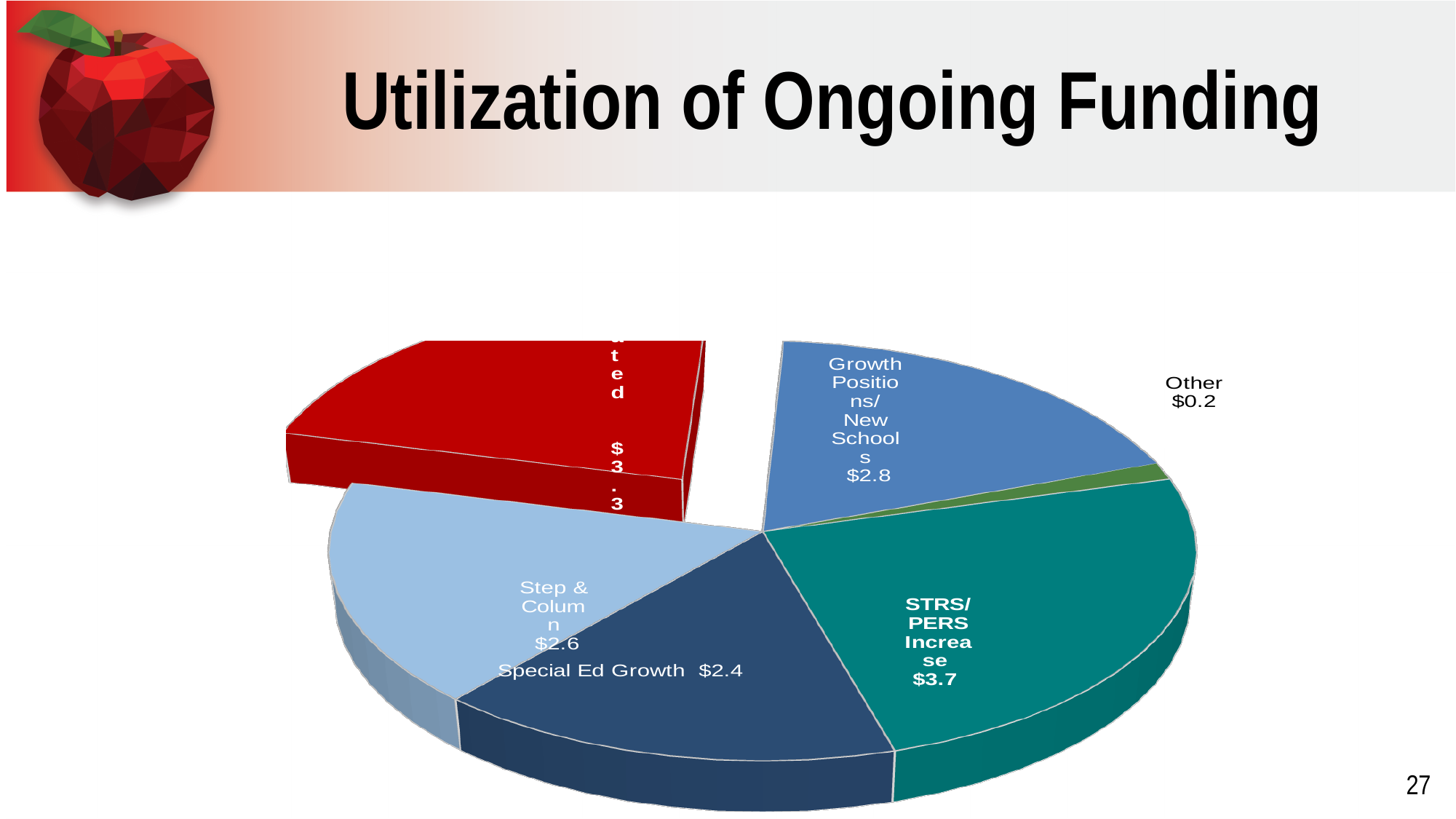
What is the value shown for Special Ed Growth? $2.4 Which category has the largest value in the pie chart? STRS/PERS Increase Which category has the smallest value in the pie chart? Other What is the value shown for Other? $0.2 What is the value shown for Step & Column? $2.6 What is the value shown for Growth Positions/New Schools? $2.8 How many slices does the pie chart have? 6 What is the value shown for STRS/PERS Increase? $3.7 What type of chart is shown on the slide? Pie chart What is the title of the chart on the slide? Utilization of Ongoing Funding Which is larger, Step & Column or Special Ed Growth? Step & Column What is the difference between the values for STRS/PERS Increase and Growth Positions/New Schools? $0.9